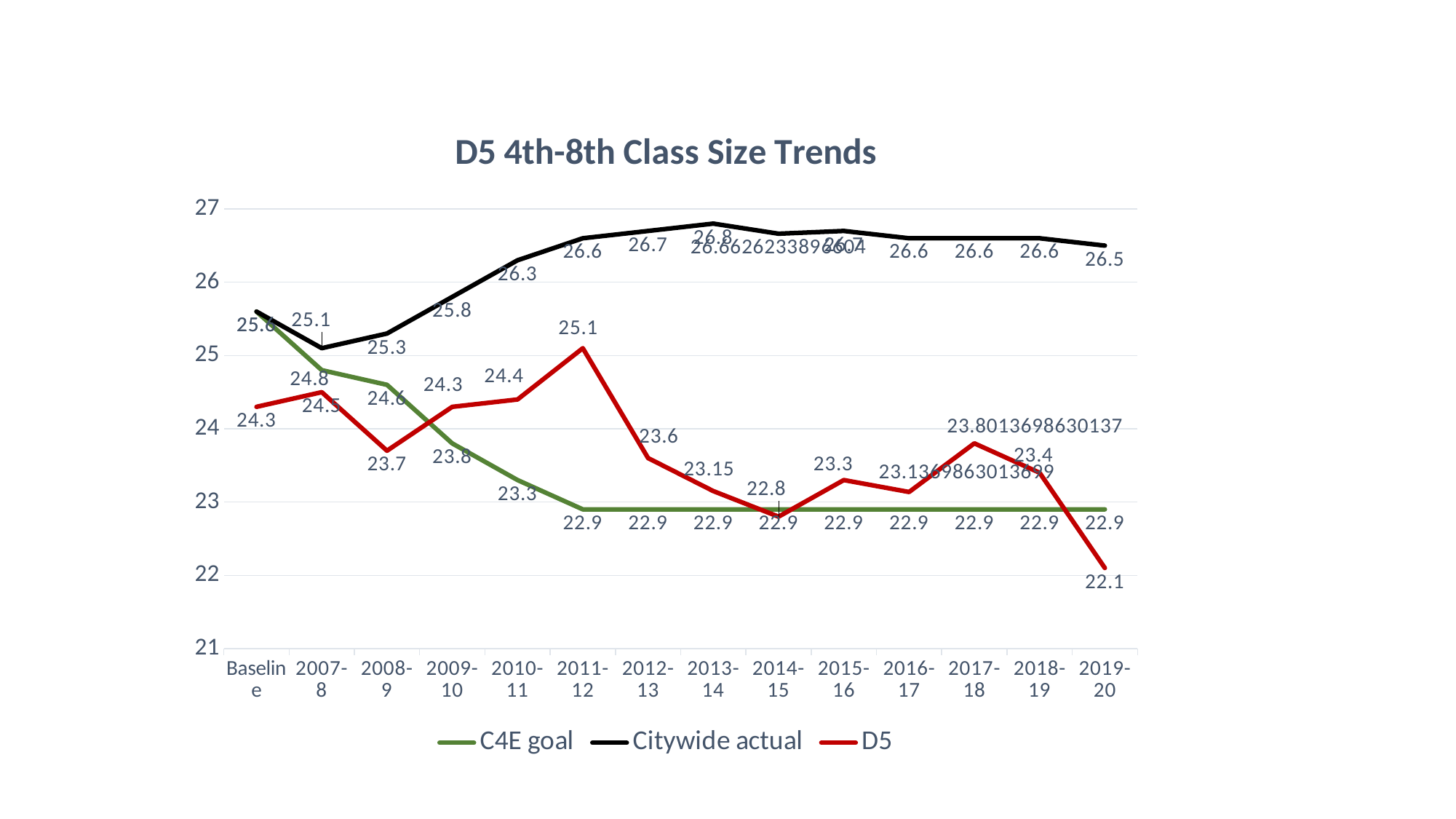
How many categories are shown on the x axis? 14 What is the difference between the D5 value in 2011-12 and the D5 value in 2019-20? 3.0 In which year does the D5 series reach its lowest value? 2019-20 What is the D5 value for 2019-20? 22.1 What type of chart is shown on the slide? line chart Is the Citywide actual value for 2013-14 greater or less than 26? greater In 2019-20, which is larger: the Citywide actual value or the D5 value? Citywide actual What is the C4E goal value for 2010-11? 23.3 In which year does the D5 series reach its highest value? 2011-12 How many series does the legend list? 3 What is the Citywide actual value for 2010-11? 26.3 What is the title of the chart? D5 4th-8th Class Size Trends